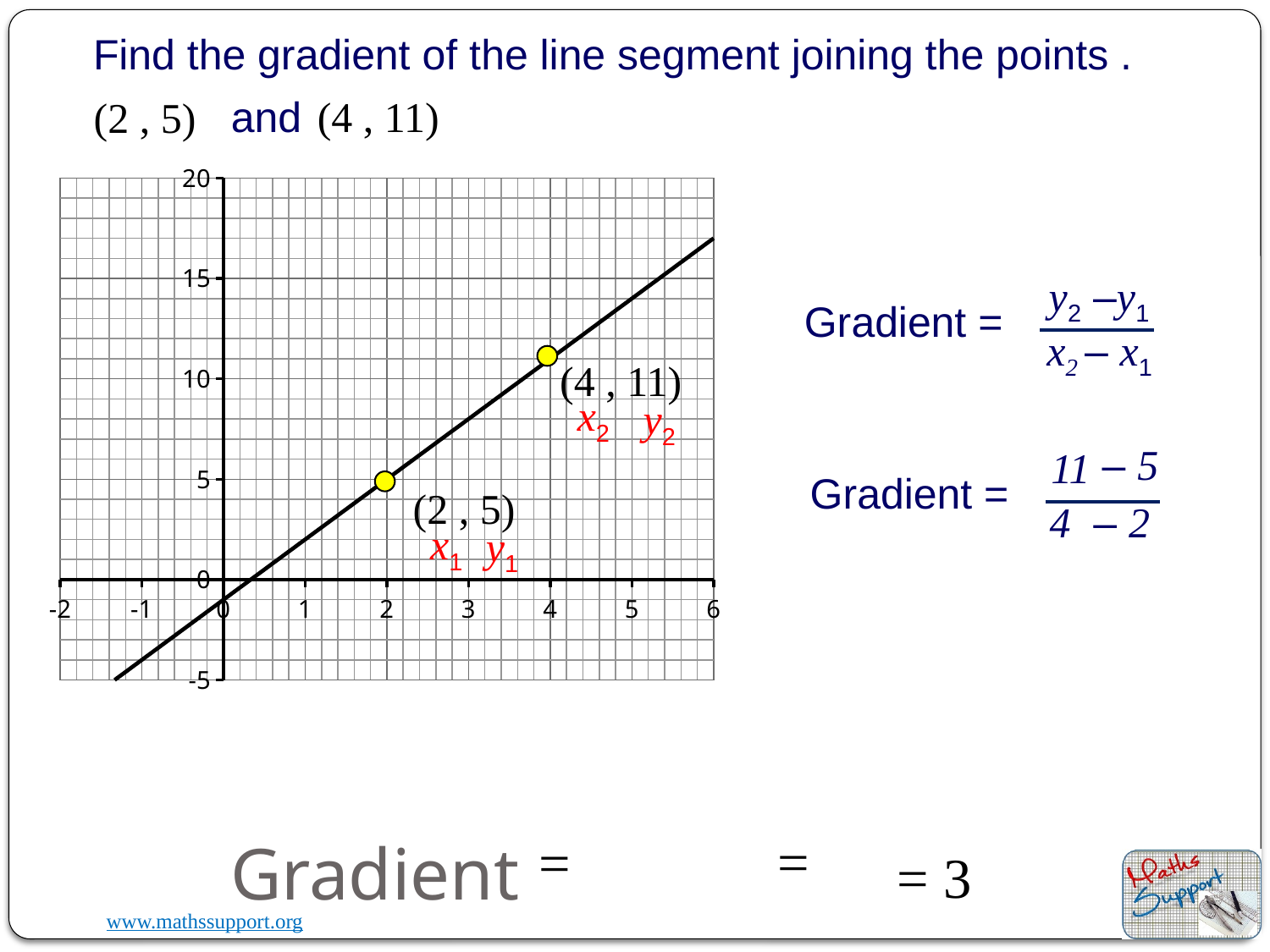
What is the highest value shown on the y axis? 20 Is the y-value of the marked point at x = 4 greater or less than 10? greater What is the y-value of the marked point at x = 2? 5 How many points are marked on the line? 2 Does the line rise or fall as x increases? rises What is the y-value of the marked point at x = 4? 11 What is the lowest value shown on the x axis? -2 What is the difference between the y-values of the two marked points? 6 Which of the two marked points is lowest on the line? (2, 5) What gradient is given for the line segment joining the two points? 3 What kind of chart is shown on the slide? line chart Which marked point has the larger y-value, (2, 5) or (4, 11)? (4, 11)